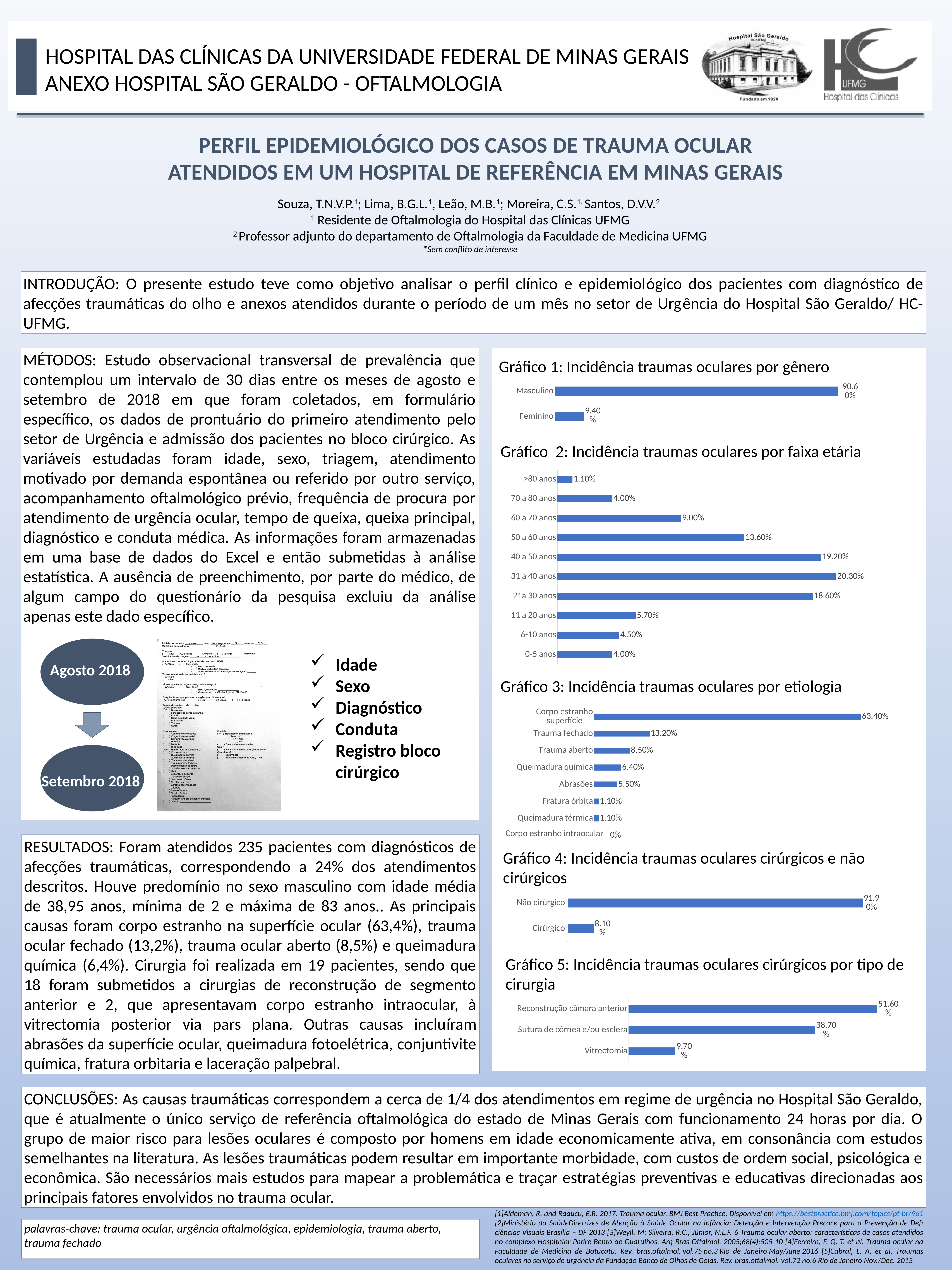
In Gráfico 3 (Incidência traumas oculares por etiologia), how many categories are shown? 8 In Gráfico 5 (Incidência traumas oculares cirúrgicos por tipo de cirurgia), what is the value for Reconstrução câmara anterior? 51.60% In Gráfico 4 (Incidência traumas oculares cirúrgicos e não cirúrgicos), what is the value for Cirúrgico? 8.10% In Gráfico 2 (Incidência traumas oculares por faixa etária), what is the value for 50 a 60 anos? 13.60% In Gráfico 5 (Incidência traumas oculares cirúrgicos por tipo de cirurgia), which is larger: Sutura de córnea e/ou esclera or Vitrectomia? Sutura de córnea e/ou esclera In Gráfico 2 (Incidência traumas oculares por faixa etária), how many age groups are shown? 10 In Gráfico 3 (Incidência traumas oculares por etiologia), what is the value for Trauma fechado? 13.20% In Gráfico 2 (Incidência traumas oculares por faixa etária), what is the difference between the values for 40 a 50 anos and 11 a 20 anos? 13.50% In Gráfico 1 (Incidência traumas oculares por gênero), what is the value for Masculino? 90.60% In Gráfico 2 (Incidência traumas oculares por faixa etária), which age group has the highest value? 31 a 40 anos In Gráfico 3 (Incidência traumas oculares por etiologia), which category has the lowest value? Corpo estranho intraocular What type of chart is Gráfico 3 (Incidência traumas oculares por etiologia)? Bar chart